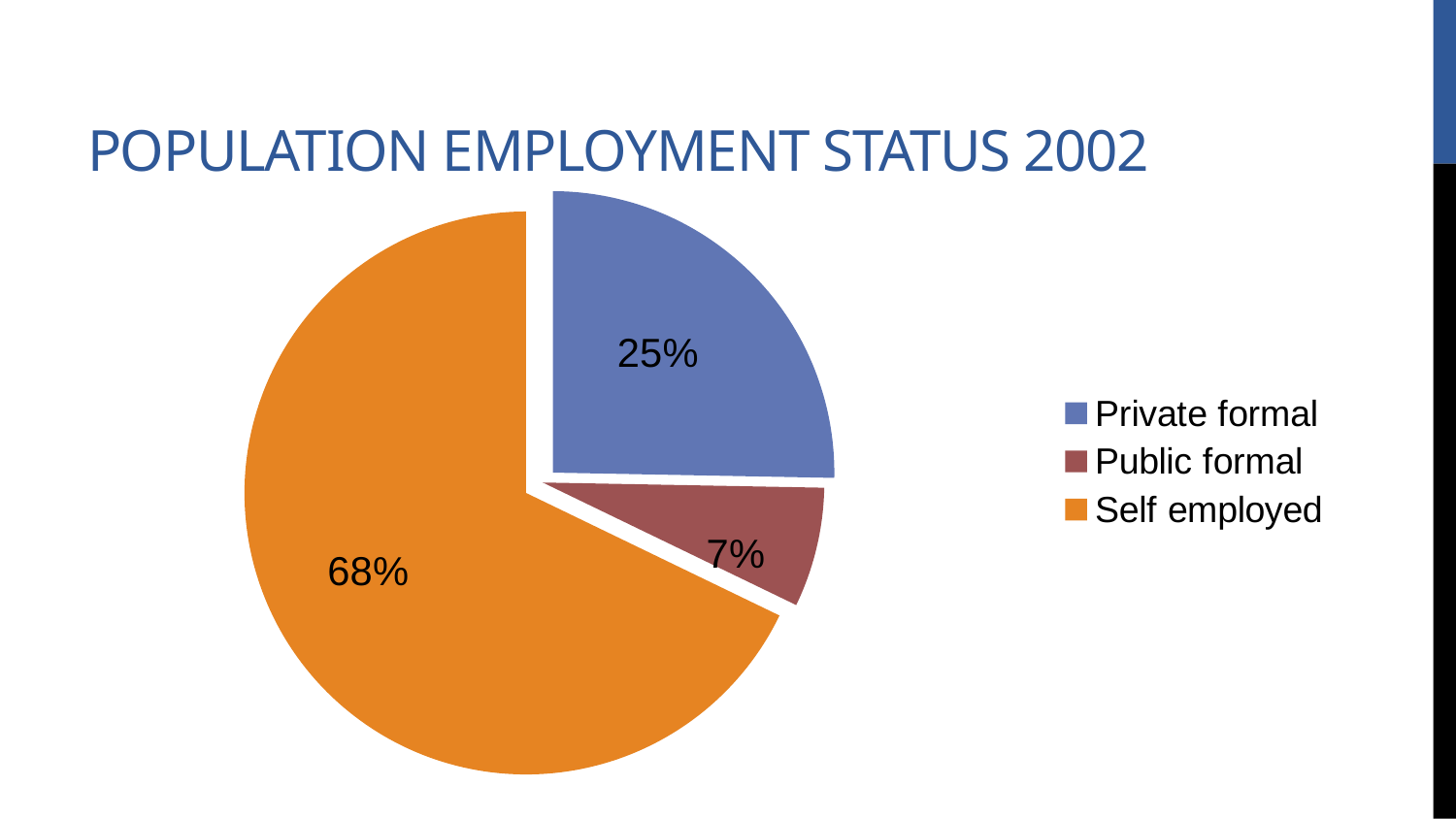
What is the title of the slide? POPULATION EMPLOYMENT STATUS 2002 What colour is the Self employed slice? Orange Which is larger, Private formal or Public formal? Private formal Which category has the largest slice of the pie? Self employed Which category has the smallest slice of the pie? Public formal What share of the pie is Public formal? 7% How many categories does the pie chart show? 3 What is the difference in percentage points between Private formal and Public formal? 18 What share of the pie is Private formal? 25% What share of the pie is Self employed? 68% What kind of chart is shown on the slide? Pie chart What is the difference in percentage points between Self employed and Private formal? 43